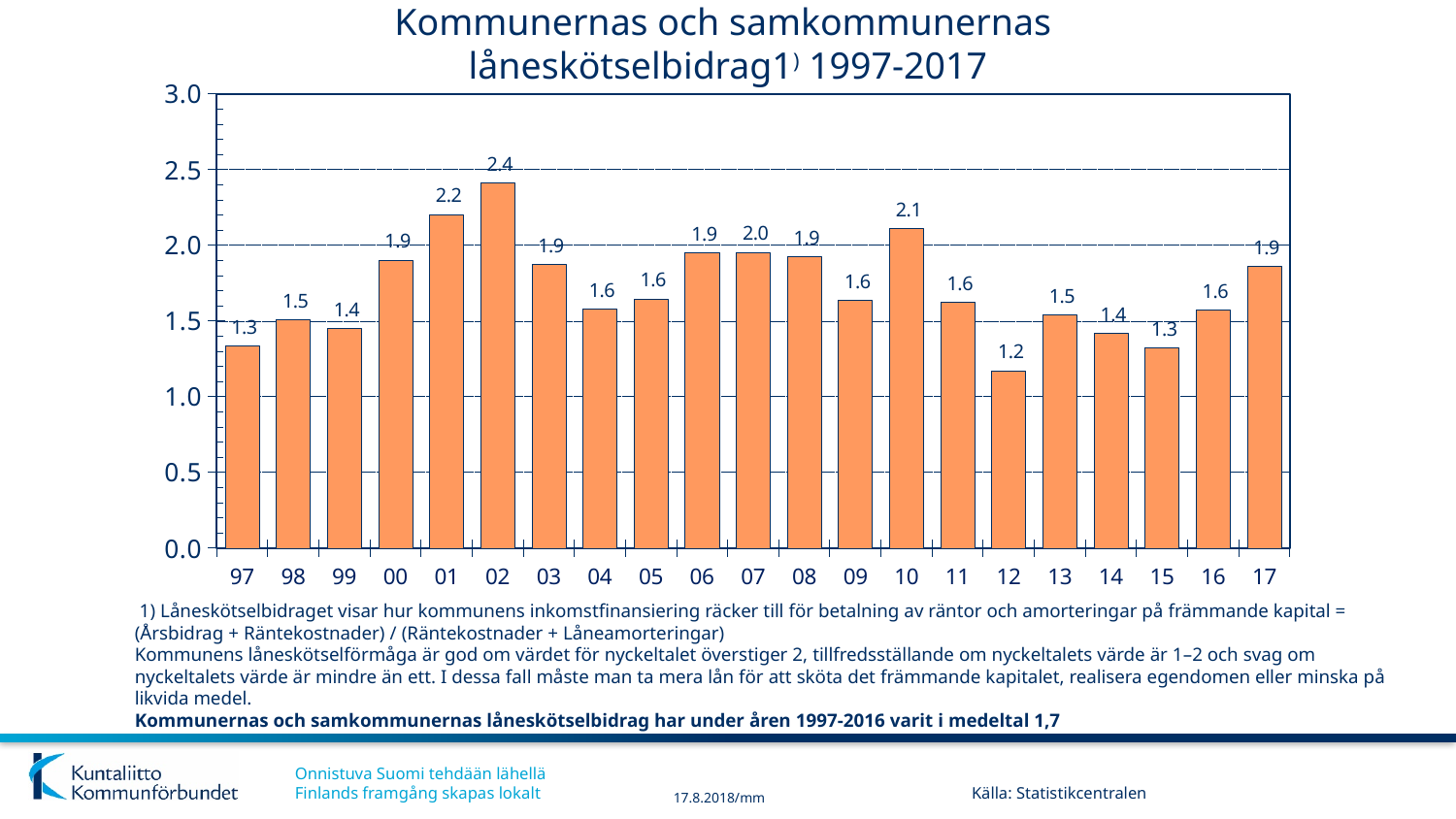
What is the value for 10? 2.1 Do the values rise or fall from 97 to 02? rise How many years are shown on the x axis? 21 Is the value for 02 greater or less than 2.0? greater Which year has the lowest value? 12 What is the value for 02? 2.4 What kind of chart is this? bar chart Which year has the highest value? 02 What is the value for 17? 1.9 What is the value for 12? 1.2 Which is larger, the value for 01 or the value for 10? 01 What is the difference between the values for 02 and 12? 1.2